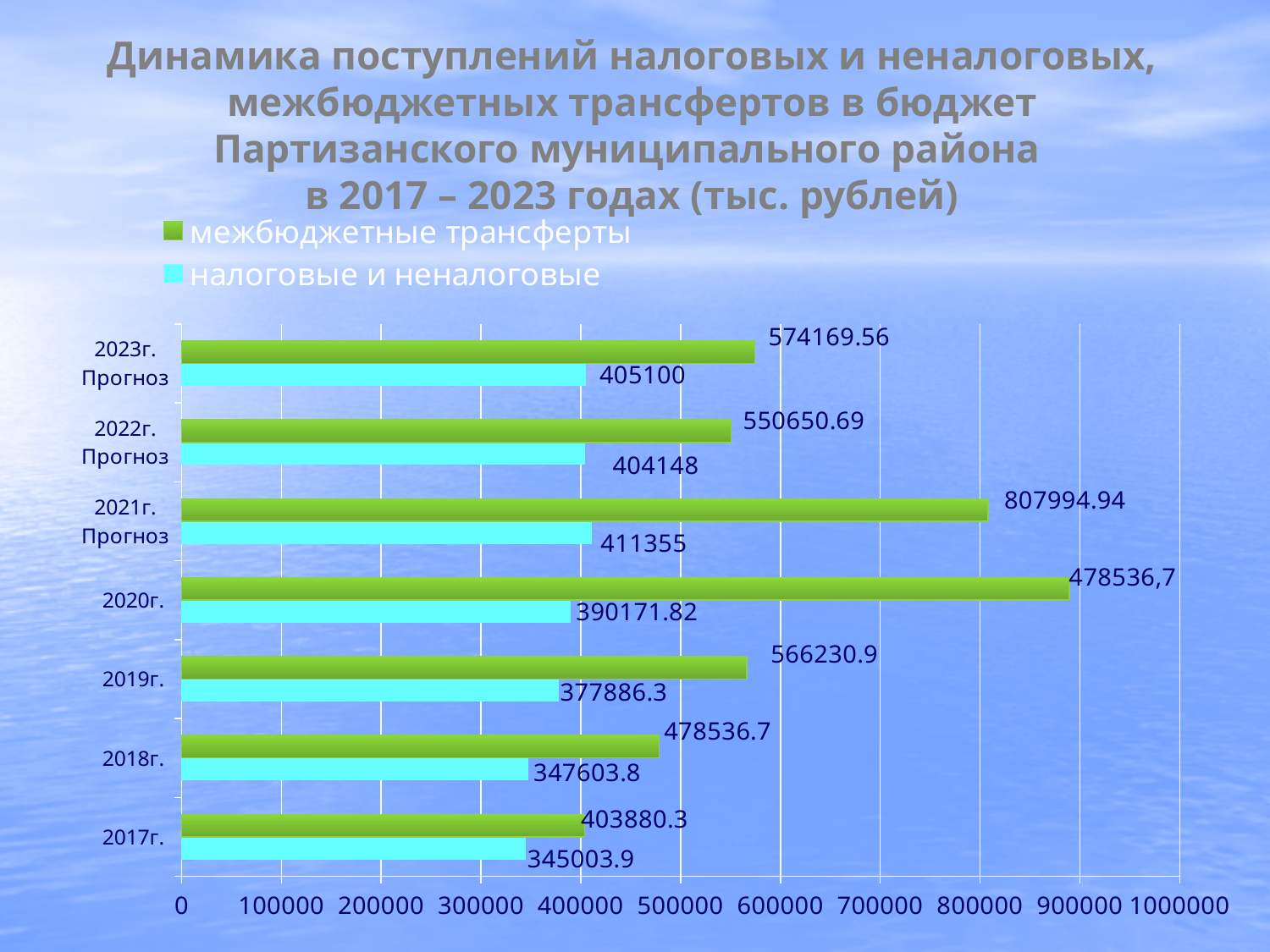
What is the value of межбюджетные трансферты for 2023г. Прогноз? 574169.56 How many series does the legend list? 2 What is the value of налоговые и неналоговые for 2017г.? 345003.9 Which is larger: межбюджетные трансферты for 2019г. or for 2022г. Прогноз? 2019г. Which year has the lowest value of межбюджетные трансферты? 2017г. What kind of chart is shown on the slide? bar chart How many year categories are shown on the chart? 7 What is the value of налоговые и неналоговые for 2022г. Прогноз? 404148 Which year has the highest value of налоговые и неналоговые? 2021г. Прогноз What is the difference between межбюджетные трансферты and налоговые и неналоговые for 2018г.? 130932.9 What is the value of межбюджетные трансферты for 2021г. Прогноз? 807994.94 Is the value of налоговые и неналоговые for 2019г. greater or less than 400000? less